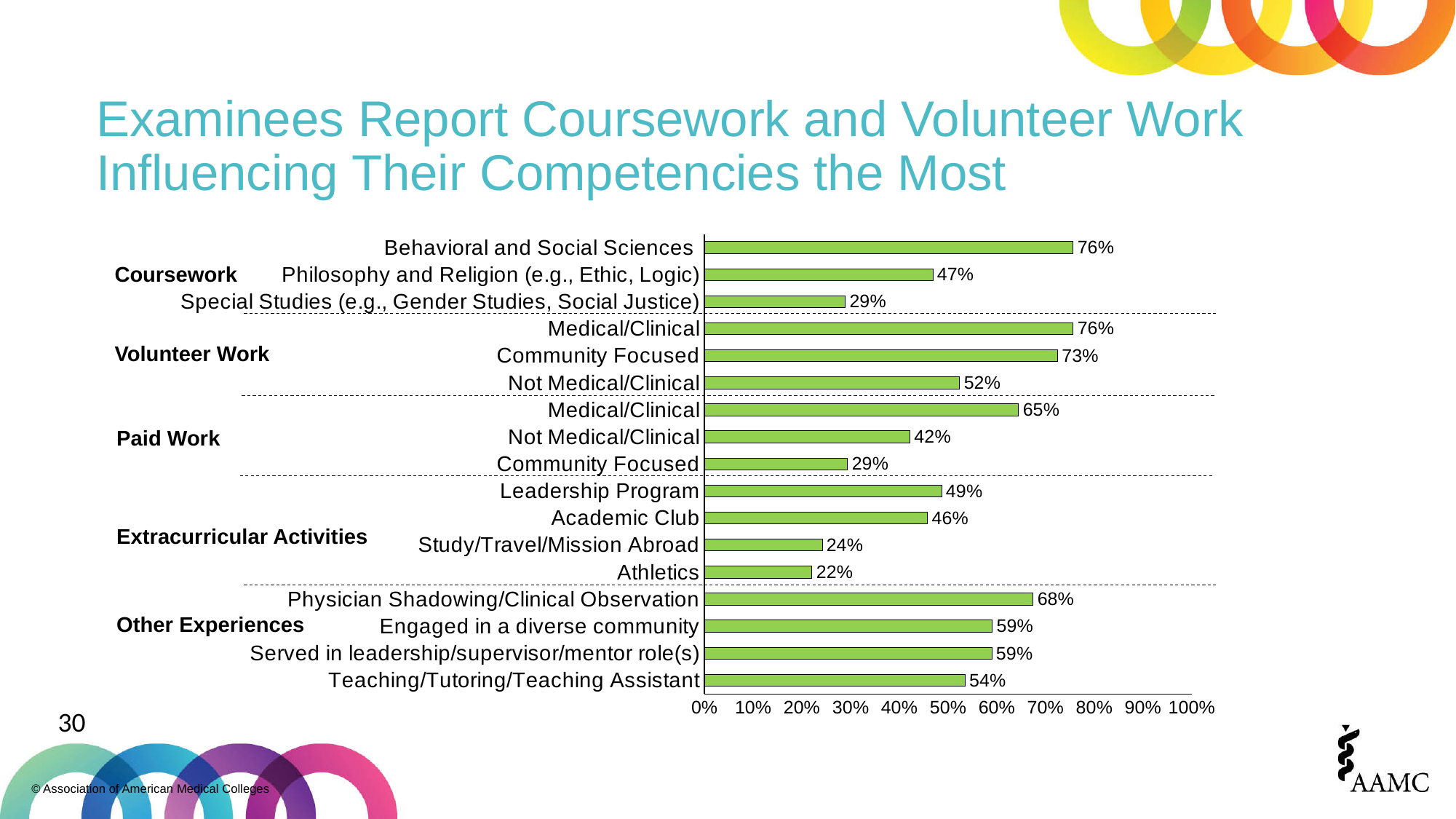
How many experience groups (e.g., Coursework, Volunteer Work) are labeled on the chart? 5 What is the difference between Community Focused Volunteer Work and Community Focused Paid Work? 44% Which is larger: Leadership Program or Academic Club? Leadership Program What percentage is shown for Physician Shadowing/Clinical Observation? 68% What percentage is shown for Medical/Clinical under Paid Work? 65% What percentage is shown for Behavioral and Social Sciences under Coursework? 76% How many bars are plotted on the chart? 17 What kind of chart is shown on the slide? Bar chart What percentage is shown for Athletics under Extracurricular Activities? 22% What is the maximum value shown on the x axis? 100% What is the difference between Medical/Clinical Volunteer Work (76%) and Medical/Clinical Paid Work (65%)? 11% Which category has the lowest percentage on the chart? Athletics